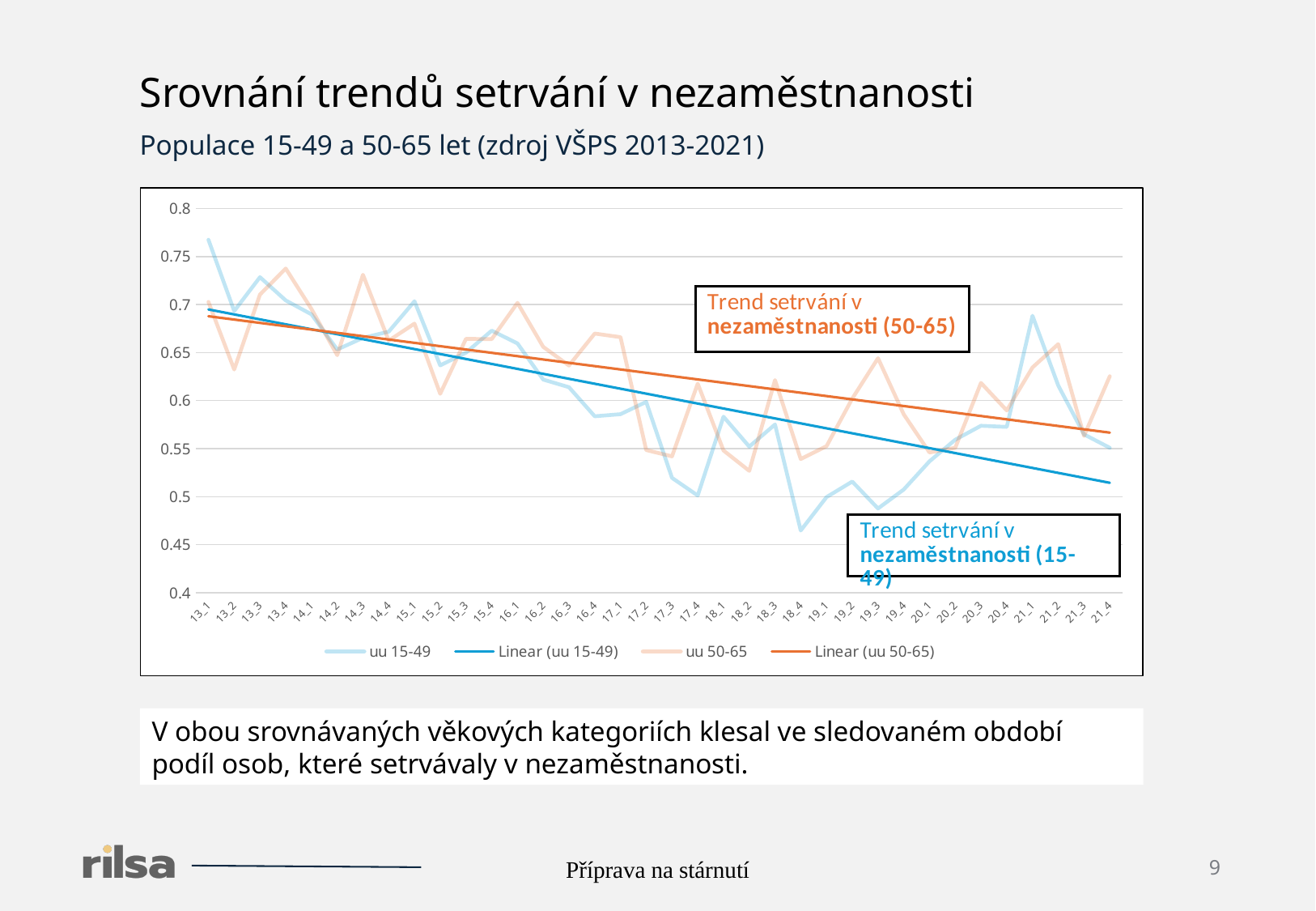
Is the value of the Linear (uu 15-49) trend line at 21_4 greater or less than 0.55? less Does the Linear (uu 15-49) trend line rise or fall along the x axis? fall At which x-axis point does the uu 15-49 series reach its highest value? 13_1 Is the value of uu 15-49 at 18_4 greater or less than 0.5? less What is the title of the slide containing the chart? Srovnání trendů setrvání v nezaměstnanosti How many points are on the x axis of the chart (from 13_1 to 21_4)? 36 Is the value of uu 50-65 at 13_4 greater or less than 0.7? greater How many entries does the chart legend list? 4 What kind of chart is shown on the slide? line chart Does the Linear (uu 50-65) trend line rise or fall along the x axis? fall At 18_4, which series has the higher value, uu 15-49 or uu 50-65? uu 50-65